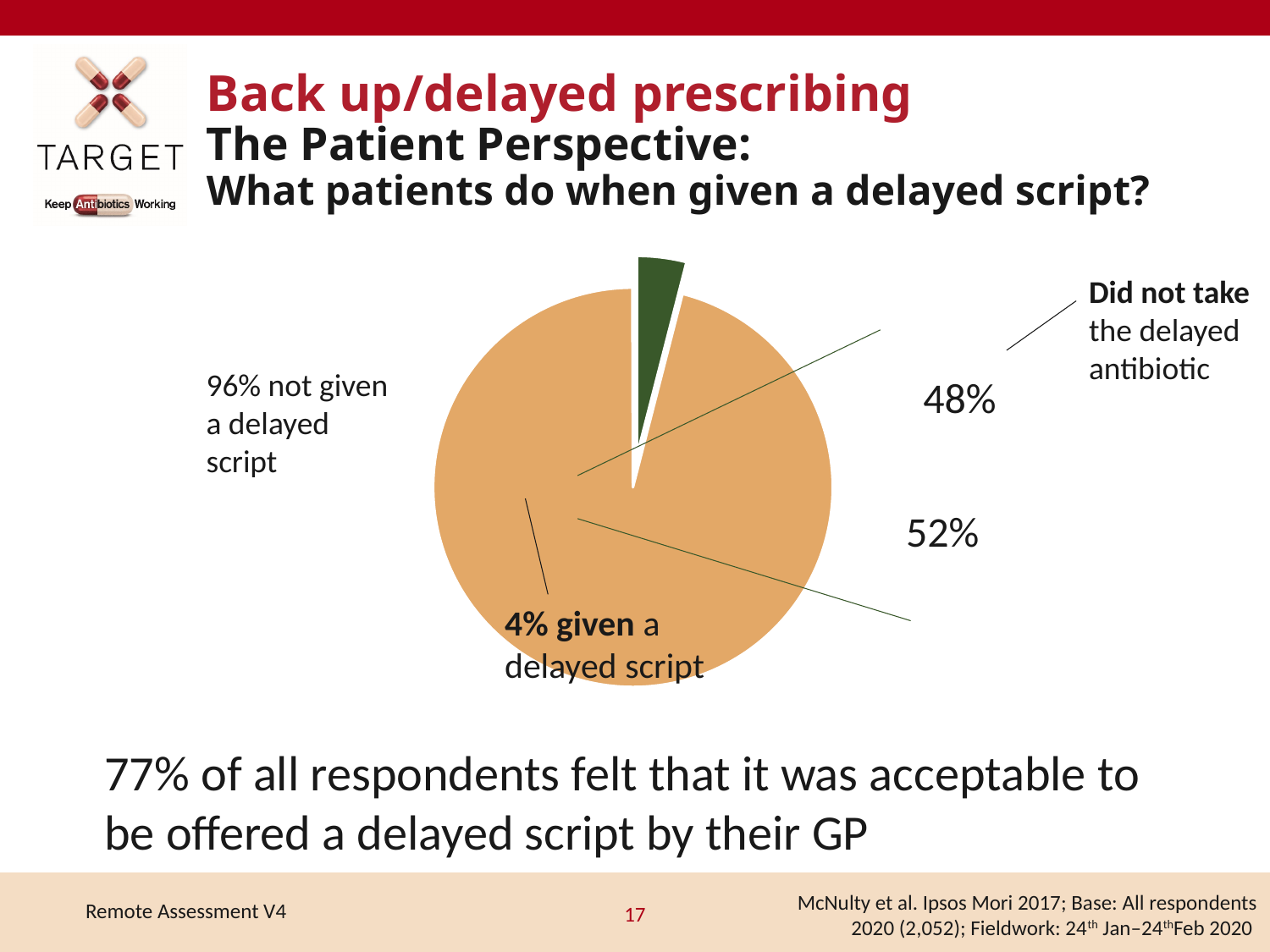
What percentage of patients were given a delayed script? 4% Is the share of patients given a delayed script greater or less than 50%? less What is the total of the two pie slices (96% and 4%)? 100% Which slice of the pie chart is the largest? 96% not given a delayed script What percentage of those given a delayed script did not take the delayed antibiotic? 48% Which is larger: the share of patients not given a delayed script or the share given a delayed script? not given a delayed script What colour is the slice representing the 4% given a delayed script? green What kind of chart is shown on the slide? pie chart How many slices does the pie chart have? 2 Which slice of the pie chart is the smallest? 4% given a delayed script What is the difference in percentage points between patients not given a delayed script and those given one? 92 percentage points What percentage of patients were not given a delayed script? 96%